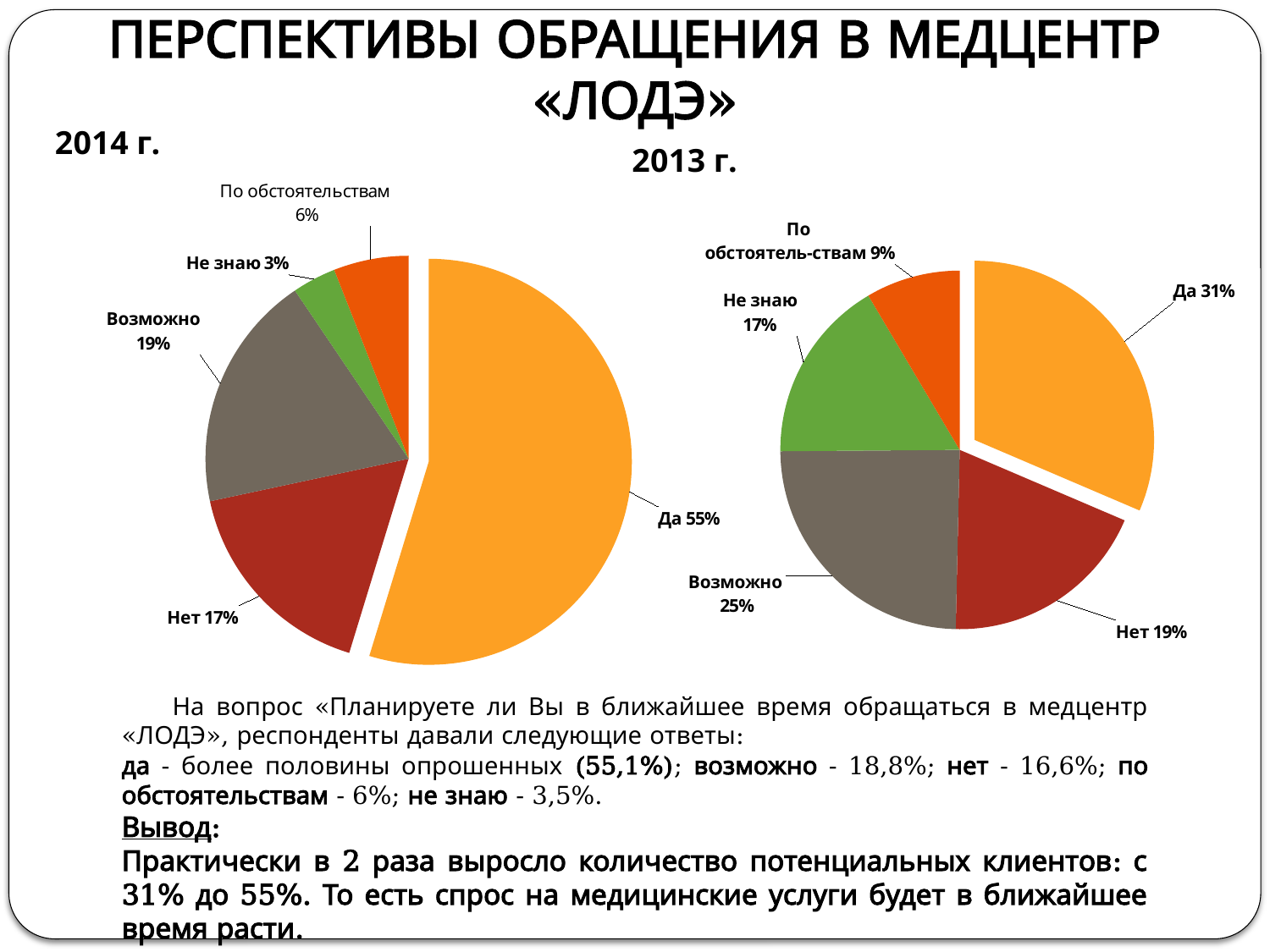
In the 2014 pie chart, which category has the smallest slice? Не знаю What type of chart is used for the 2013 data? Pie chart What is the difference between the "Да" share in the 2014 chart and the "Да" share in the 2013 chart? 24% In the 2013 pie chart, what share of respondents answered "Да"? 31% In the 2014 pie chart, what is the value for "Возможно"? 19% In the 2014 pie chart, which category has the largest slice? Да How many categories does the 2014 pie chart show? 5 In the 2013 pie chart, what is the value for "Не знаю"? 17% In the 2013 pie chart, which is larger: "Возможно" or "Нет"? Возможно In the 2014 pie chart, what share of respondents answered "Да"? 55% In the 2013 pie chart, which category has the smallest slice? По обстоятельствам In the 2013 pie chart, what is the difference between "Нет" and "По обстоятельствам"? 10%